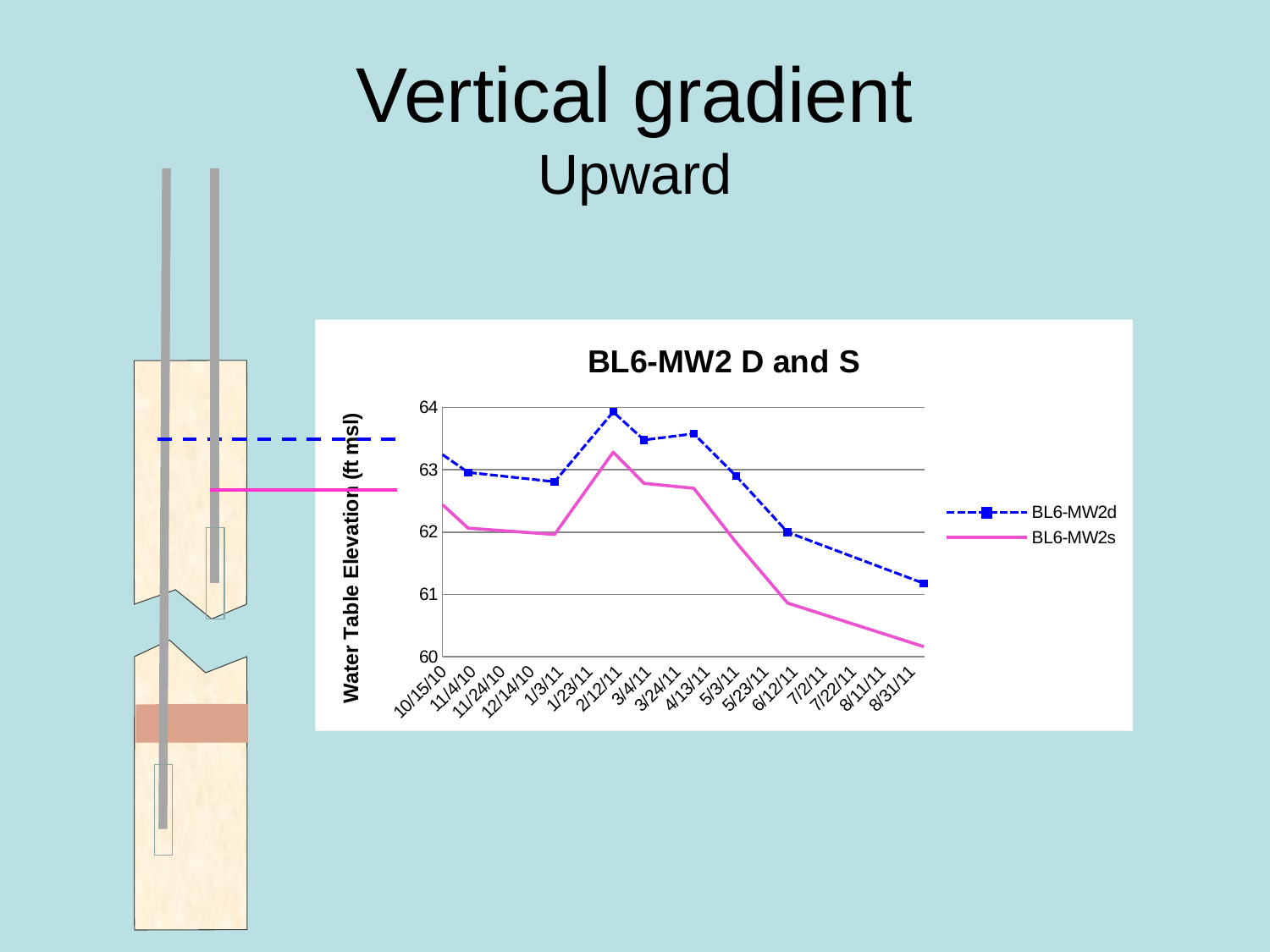
What is the title of the vertical axis of the chart? Water Table Elevation (ft msl) What kind of chart is shown on the slide? line chart On which date does the BL6-MW2s series reach its lowest value? 8/31/11 Is the BL6-MW2d value on 2/12/11 greater or less than 63? greater Does the BL6-MW2d series rise or fall from 3/24/11 to 8/31/11? fall How many series does the legend of the BL6-MW2 D and S chart list? 2 On which date does the BL6-MW2d series reach its highest value? 2/12/11 What are the two series named in the legend of the chart? BL6-MW2d and BL6-MW2s Is the BL6-MW2s value on 10/15/10 greater or less than 62? greater For the BL6-MW2d series, which date has the larger value, 10/15/10 or 2/12/11? 2/12/11 On 2/12/11, which series has the higher water table elevation, BL6-MW2d or BL6-MW2s? BL6-MW2d Is the BL6-MW2s value on 6/12/11 greater or less than 61? less